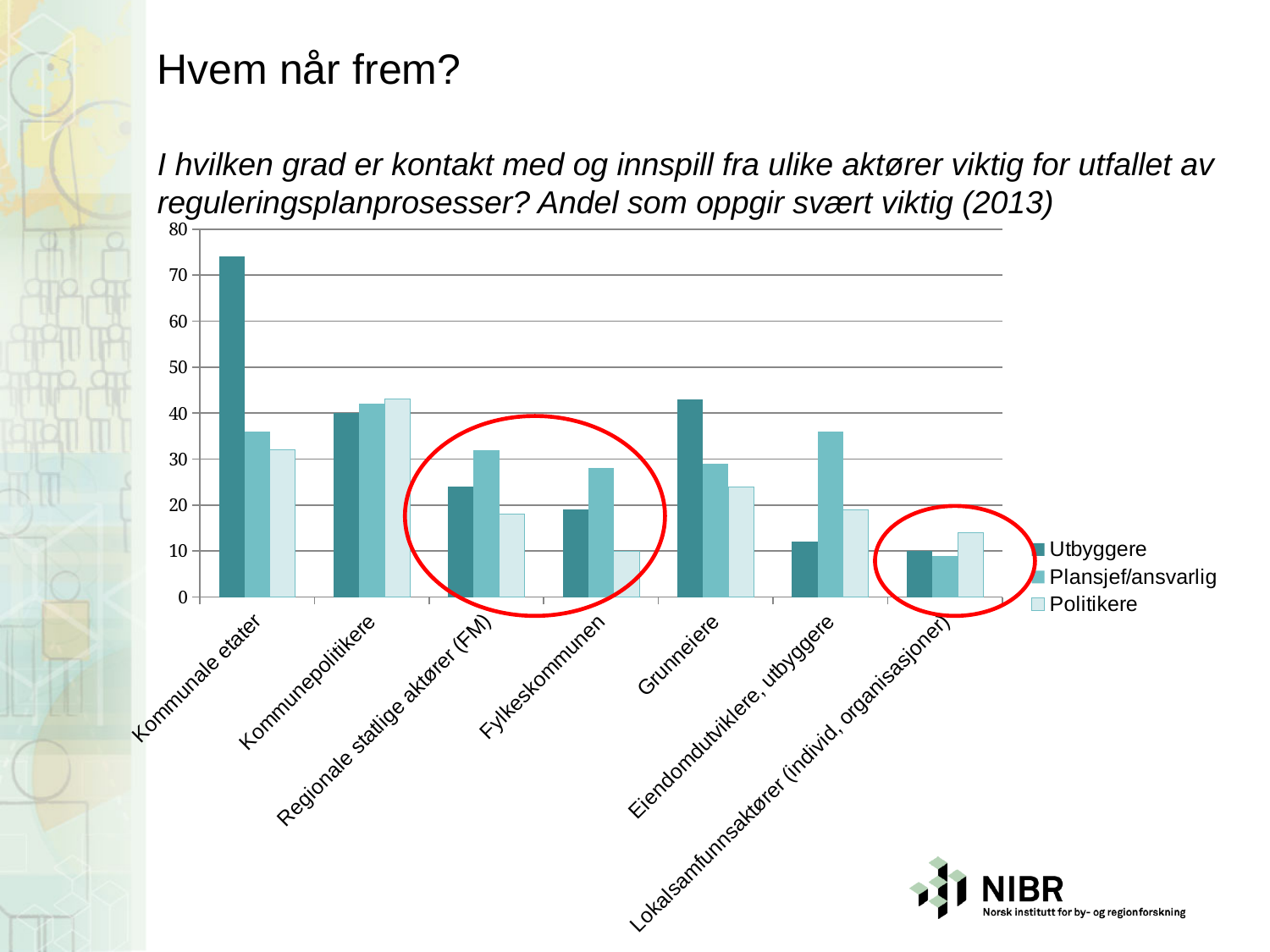
Is the Politikere value for Fylkeskommunen greater or less than 20? less What kind of chart is shown on the slide? bar chart How many series does the legend list? 3 Is the Utbyggere value for Kommunale etater greater or less than 70? greater How many categories are shown on the x axis? 7 For the Utbyggere series, which category has the highest value? Kommunale etater For Eiendomdutviklere, utbyggere, which is larger: the Utbyggere value or the Plansjef/ansvarlig value? Plansjef/ansvarlig How many groups of bars are circled in red on the chart? 3 For Kommunale etater, which is larger: the Utbyggere value or the Plansjef/ansvarlig value? Utbyggere Is the Politikere value for Kommunale etater greater or less than 20? greater What are the three series listed in the legend? Utbyggere, Plansjef/ansvarlig, Politikere For the Plansjef/ansvarlig series, which category has the lowest value? Lokalsamfunnsaktører (individ, organisasjoner)